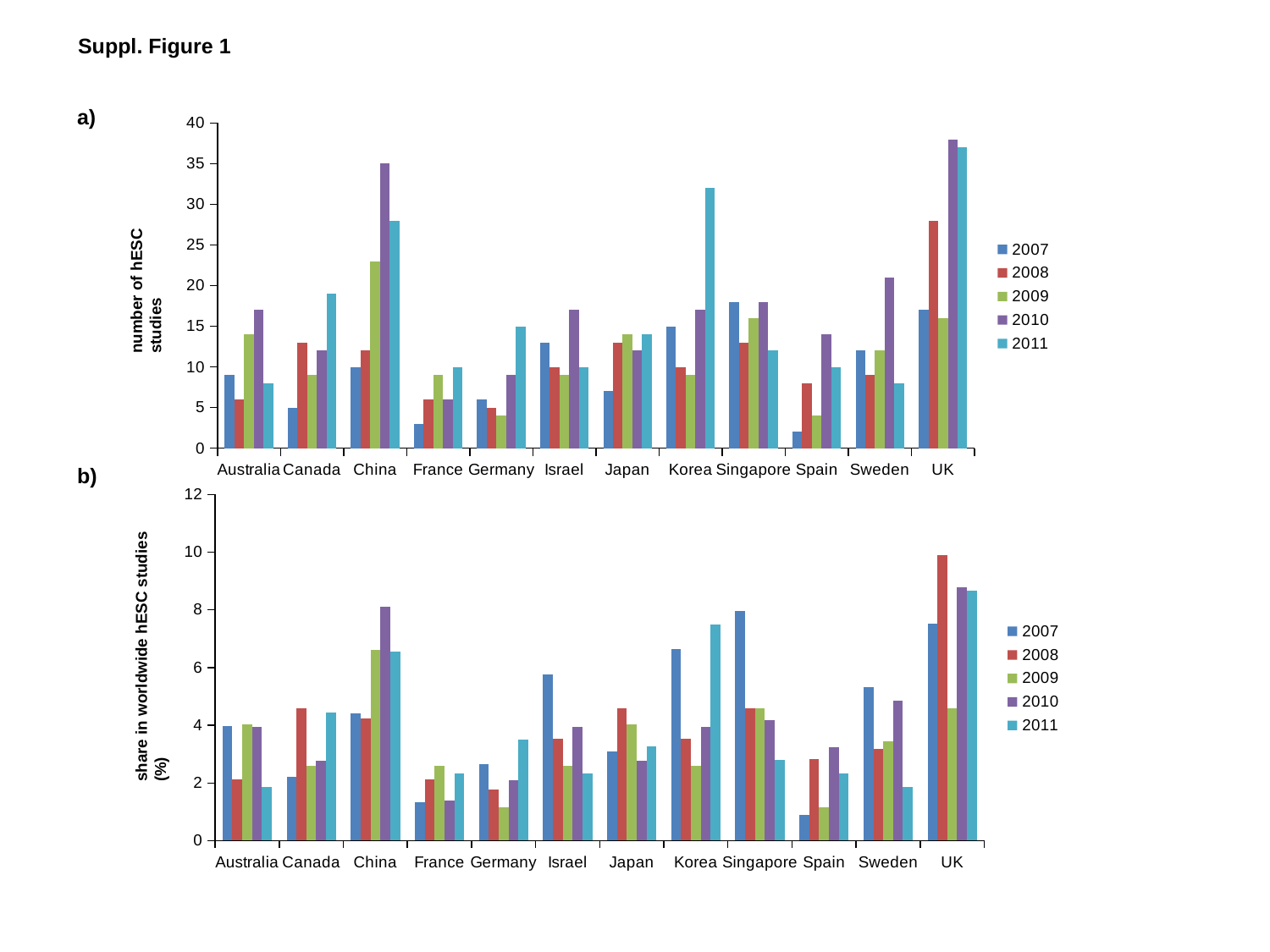
In chart a), is the value for Spain in 2007 greater or less than 5? less In chart b), how many series does the legend list? 5 In chart b), is the value for UK in 2008 greater or less than 8? greater In chart b), which year has the lowest share for Spain? 2007 In chart a), is the value for Korea in 2011 greater or less than 30? greater In chart a), how many countries are shown on the x axis? 12 What is the y-axis title of chart b)? share in worldwide hESC studies (%) In chart a), which year has the highest number of hESC studies for Korea? 2011 What kind of chart is chart a)? bar chart In chart a), which is larger for Canada: the 2007 value or the 2008 value? 2008 In chart a), which year has the highest number of hESC studies for Sweden? 2010